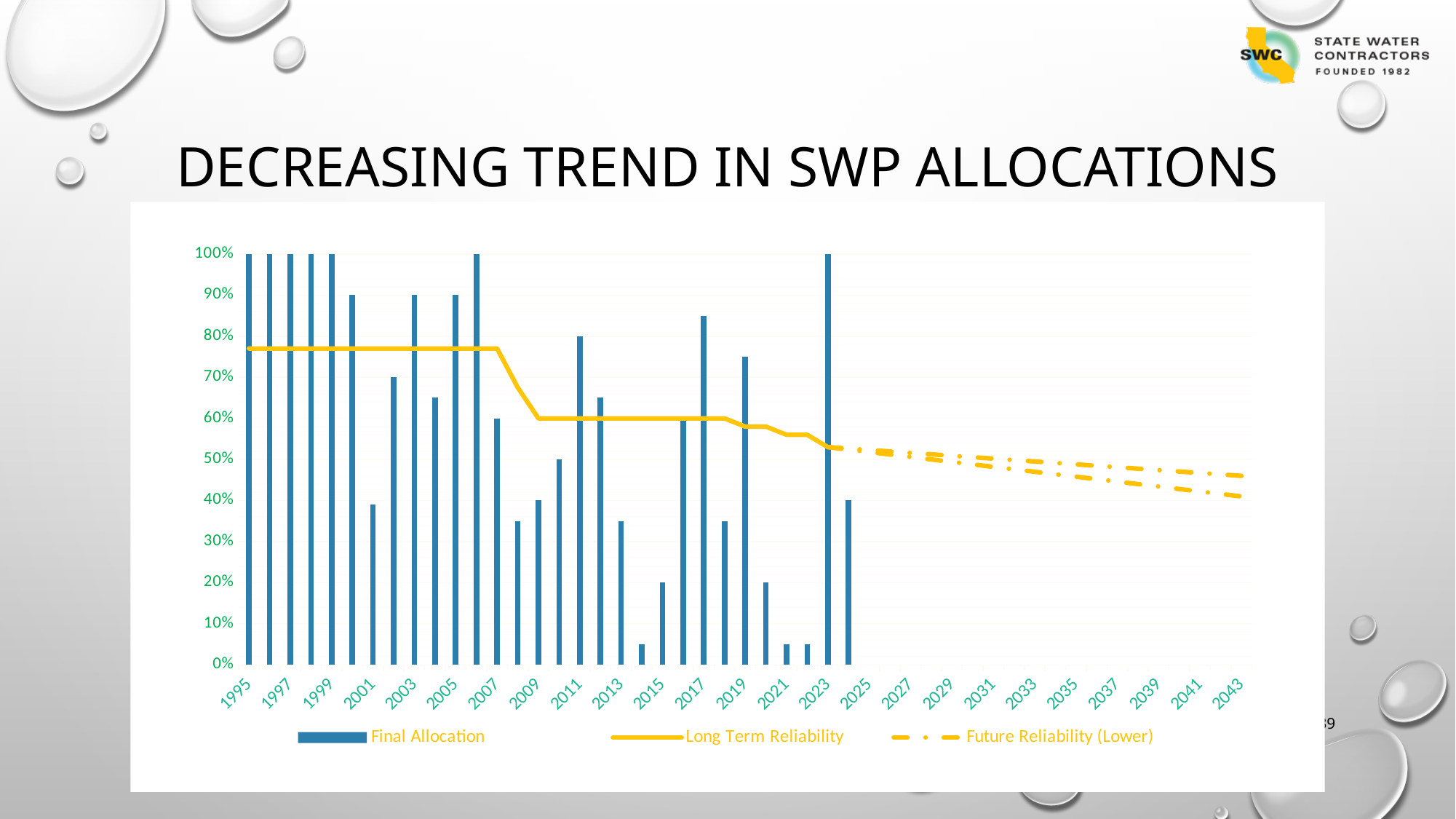
How many series does the chart legend list? 3 Is the Final Allocation for 2015 greater or less than 30%? less What is the Final Allocation value for 2023? 100% Is the Final Allocation for 2017 greater or less than 80%? greater Which year has the larger Final Allocation, 2019 or 2020? 2019 Does the Future Reliability (Lower) series rise or fall from 2025 to 2043? fall What kind of chart is shown on the slide? bar chart (with line series) What is the title of the slide containing the chart? Decreasing Trend in SWP Allocations Which year has the larger Final Allocation, 2011 or 2012? 2011 What are the three series named in the legend? Final Allocation, Long Term Reliability, Future Reliability (Lower) What is the Final Allocation value for 2024? 40% Is the Final Allocation for 2014 greater or less than 10%? less